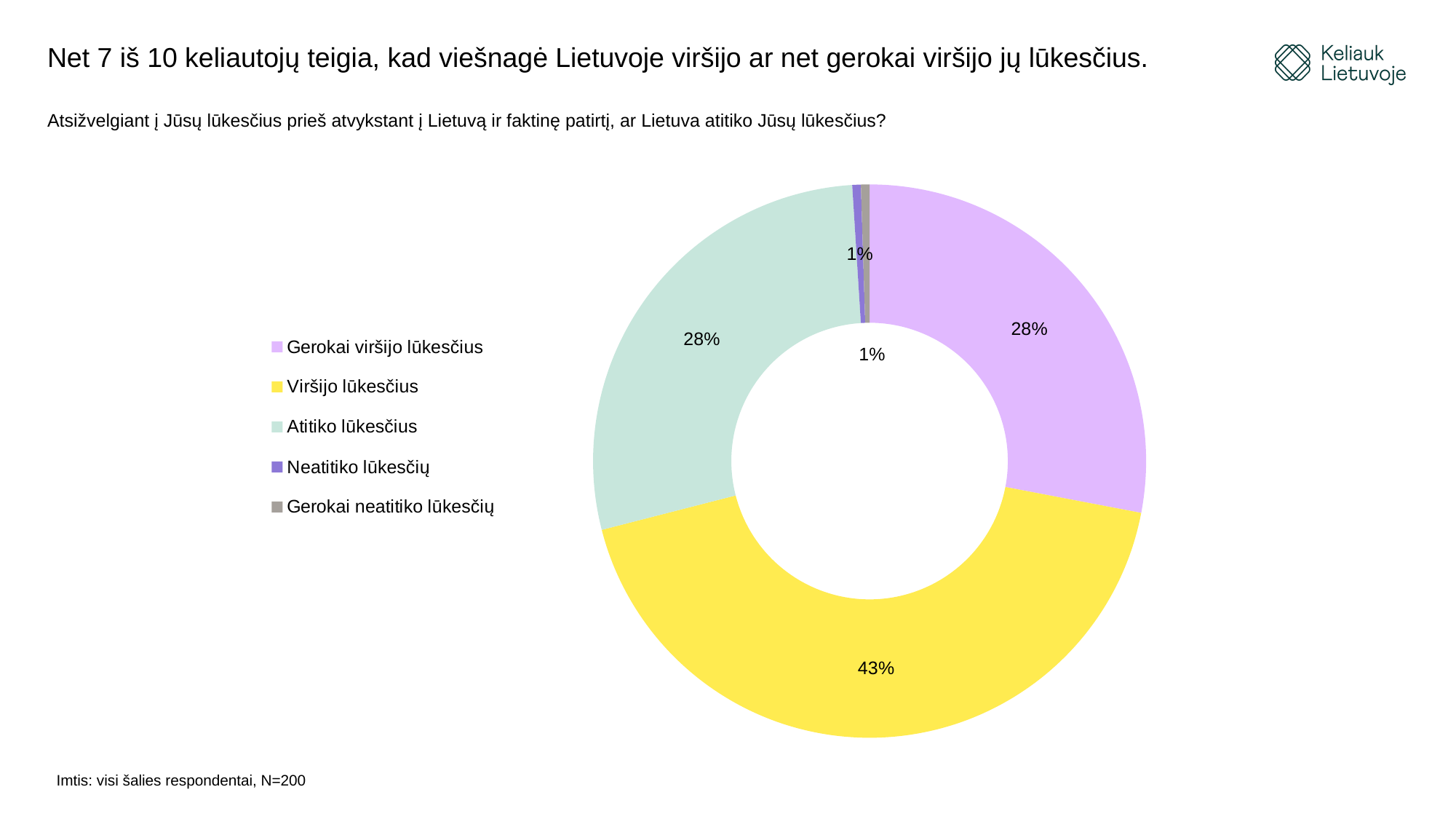
What percentage of respondents answered "Neatitiko lūkesčių"? 1% Which category has the largest share of the pie? Viršijo lūkesčius What percentage of respondents answered "Gerokai viršijo lūkesčius"? 28% What percentage of respondents answered "Atitiko lūkesčius"? 28% Which two categories each account for 1% of respondents? Neatitiko lūkesčių and Gerokai neatitiko lūkesčių What percentage of respondents answered "Viršijo lūkesčius"? 43% Which is larger: the share for "Viršijo lūkesčius" or the share for "Atitiko lūkesčius"? Viršijo lūkesčius What is the combined share of "Gerokai viršijo lūkesčius" and "Viršijo lūkesčius"? 71% What is the difference in percentage points between "Viršijo lūkesčius" and "Gerokai viršijo lūkesčius"? 15 percentage points What type of chart is shown on the slide? Pie chart (donut) What colour is the "Viršijo lūkesčius" slice? Yellow How many categories does the pie chart show? 5